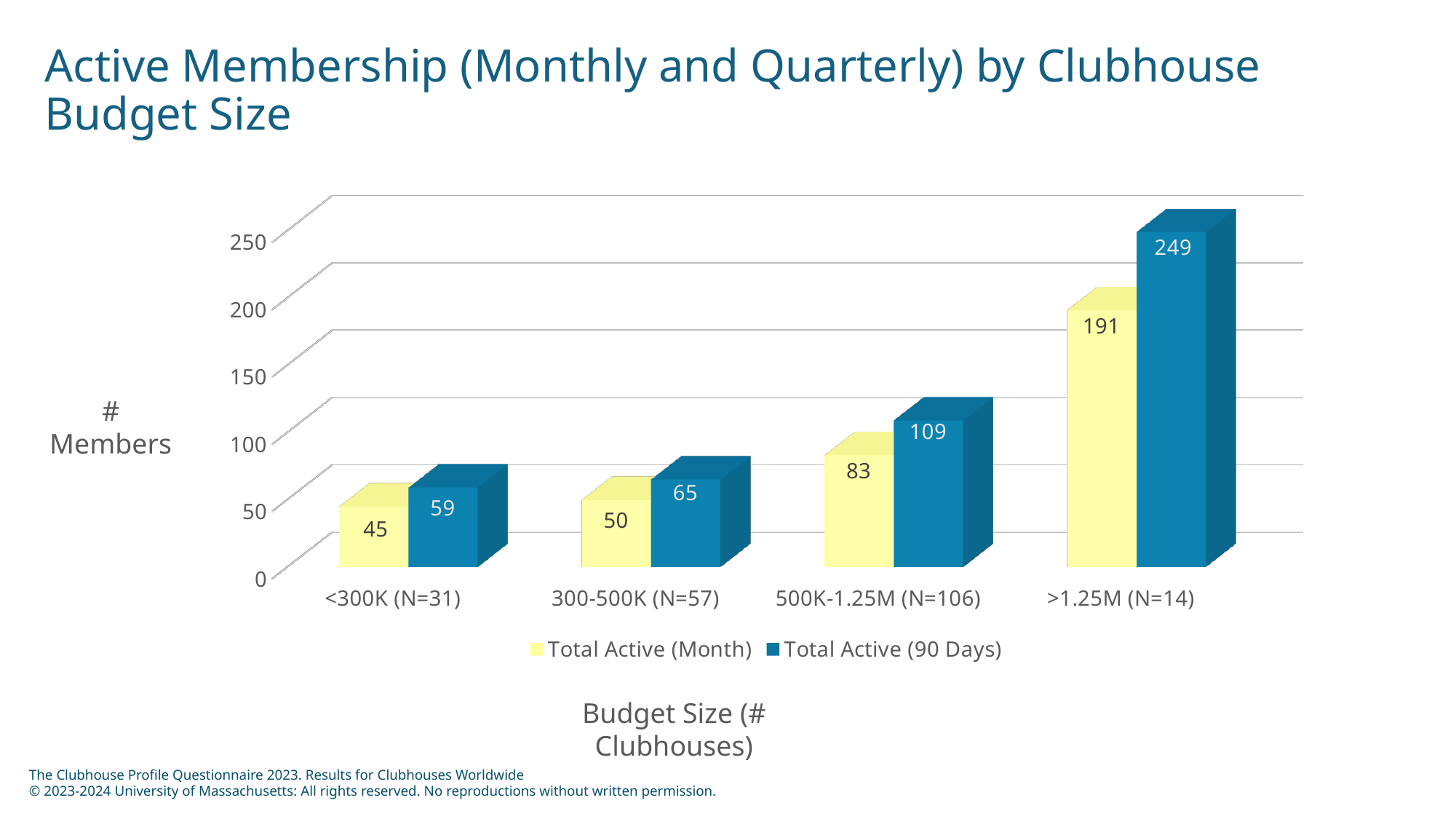
How many series does the legend list? 2 What is the label of the vertical axis? # Members How many budget size categories are shown on the x axis? 4 What is the difference between Total Active (90 Days) and Total Active (Month) for the >1.25M (N=14) budget size? 58 Which budget size has the lowest Total Active (90 Days) value? <300K (N=31) Which is larger for the 300-500K (N=57) budget size: Total Active (Month) or Total Active (90 Days)? Total Active (90 Days) Do the Total Active (90 Days) values rise or fall as budget size increases along the x axis? Rise Which budget size has the highest Total Active (Month) value? >1.25M (N=14) What kind of chart is shown on the slide? Bar chart What is the Total Active (90 Days) value for the >1.25M (N=14) budget size? 249 What is the Total Active (90 Days) value for the 500K-1.25M (N=106) budget size? 109 What is the Total Active (Month) value for the <300K (N=31) budget size? 45